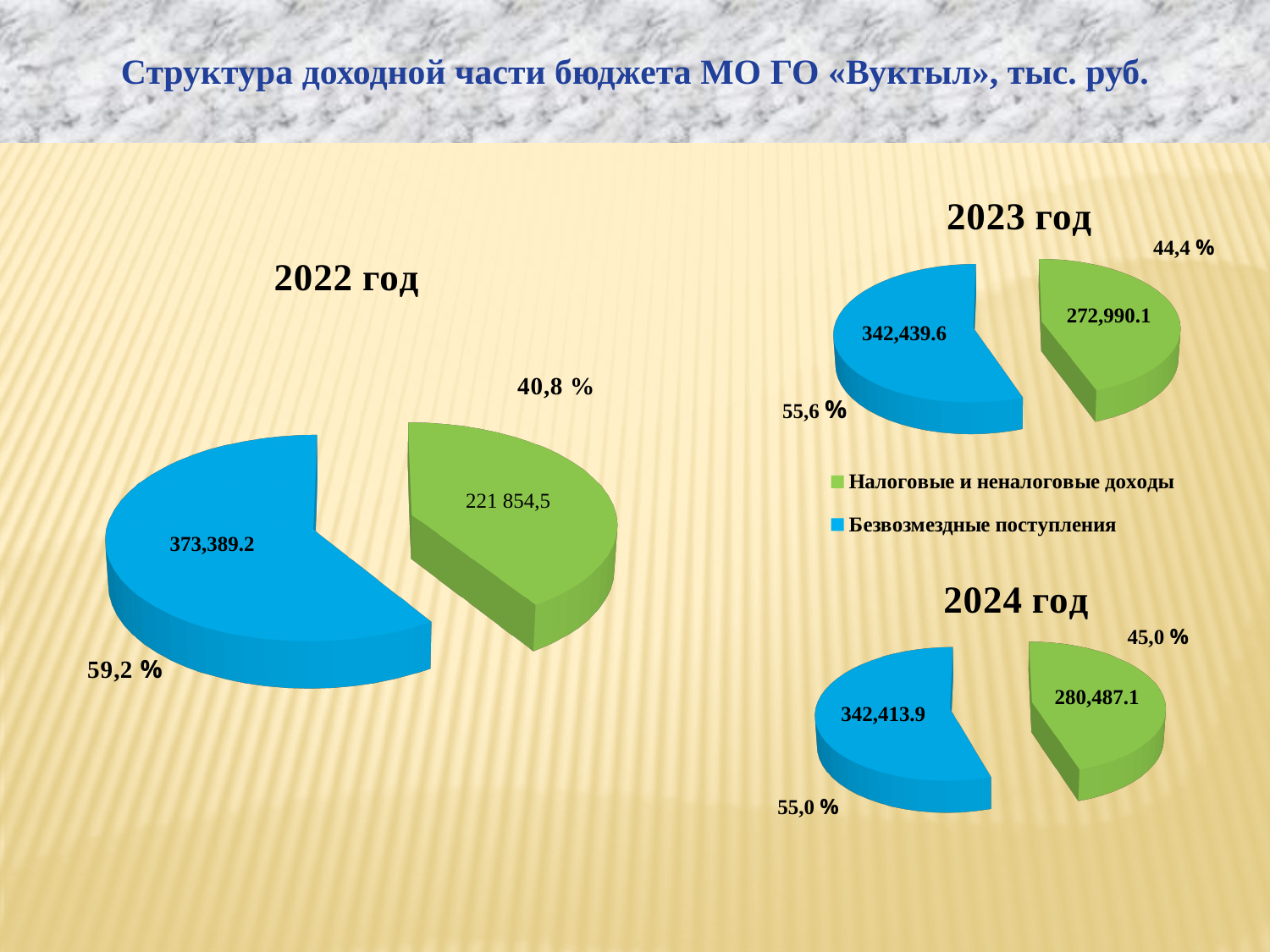
In the 2024 год chart, what is the value for Безвозмездные поступления? 342,413.9 In the 2023 год chart, what share of the pie is Налоговые и неналоговые доходы? 44,4 % How many categories does the legend list for the pie charts? 2 In the 2023 год chart, what is the value for Налоговые и неналоговые доходы? 272,990.1 In the 2022 год chart, what is the value for Безвозмездные поступления? 373,389.2 In the 2022 год chart, what is the value for Налоговые и неналоговые доходы? 221 854,5 In the 2023 год chart, what is the difference between Безвозмездные поступления and Налоговые и неналоговые доходы? 69,449.5 Which colour represents Безвозмездные поступления in the charts? blue In the 2024 год chart, what share of the pie is Налоговые и неналоговые доходы? 45,0 % What type of chart is used for the 2022 год chart? pie chart In the 2022 год chart, what share of the pie is Безвозмездные поступления? 59,2 % In the 2024 год chart, which category is the largest? Безвозмездные поступления